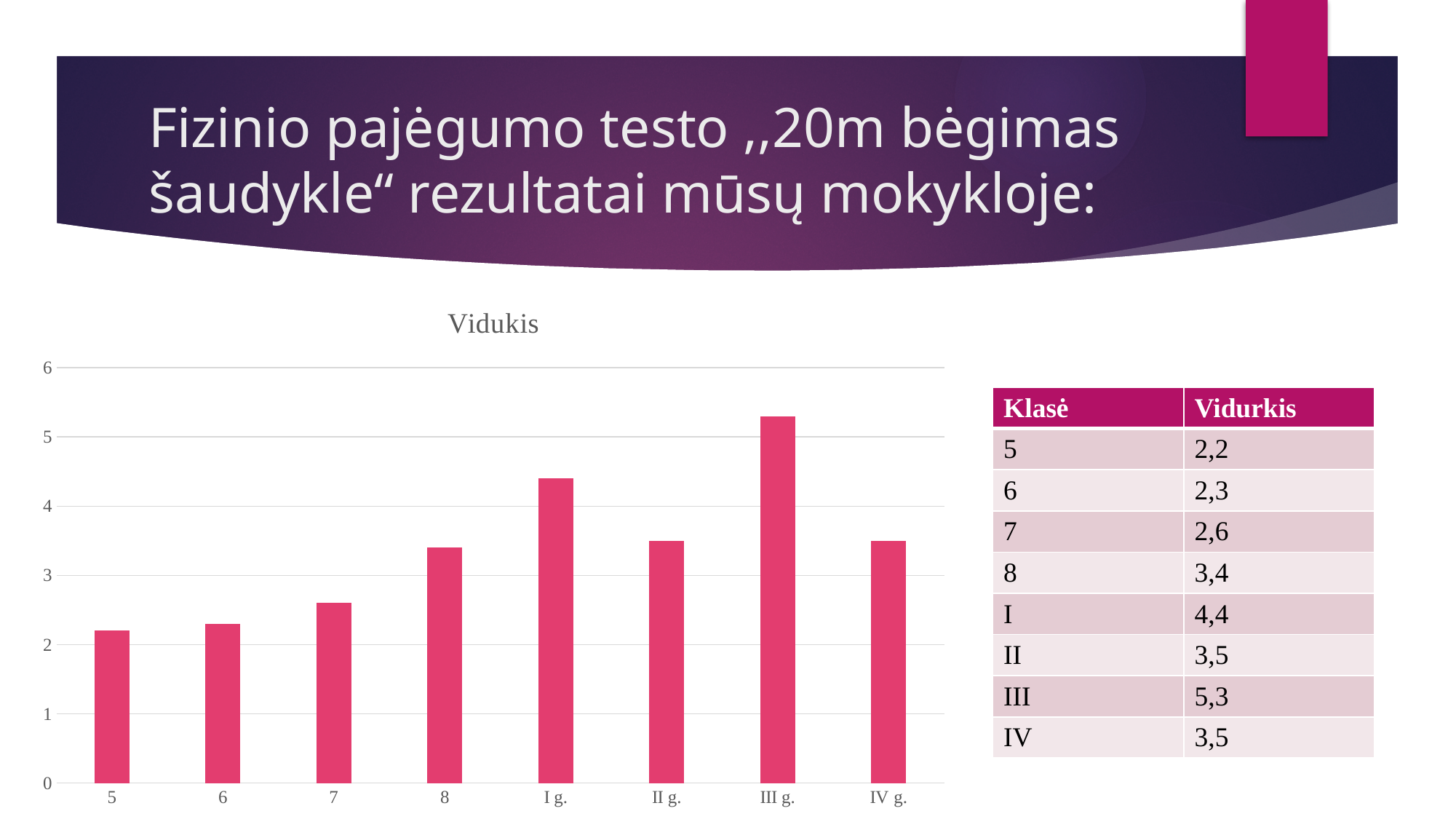
What is the title of the chart? Vidukis How many categories are shown on the x axis of the chart? 8 Is the value for I g. greater or less than 4? greater Is the value for class 6 greater or less than 3? less Which is larger, the value for I g. or the value for II g.? I g. What is the value for class 8 according to the slide? 3,4 What is the difference between the values for III g. and class 5? 3,1 Which category has the lowest bar in the chart? 5 What is the value for class 7 according to the slide? 2,6 Which category has the highest bar in the chart? III g. What is the value for III g. according to the slide? 5,3 What kind of chart is shown on the slide? bar chart